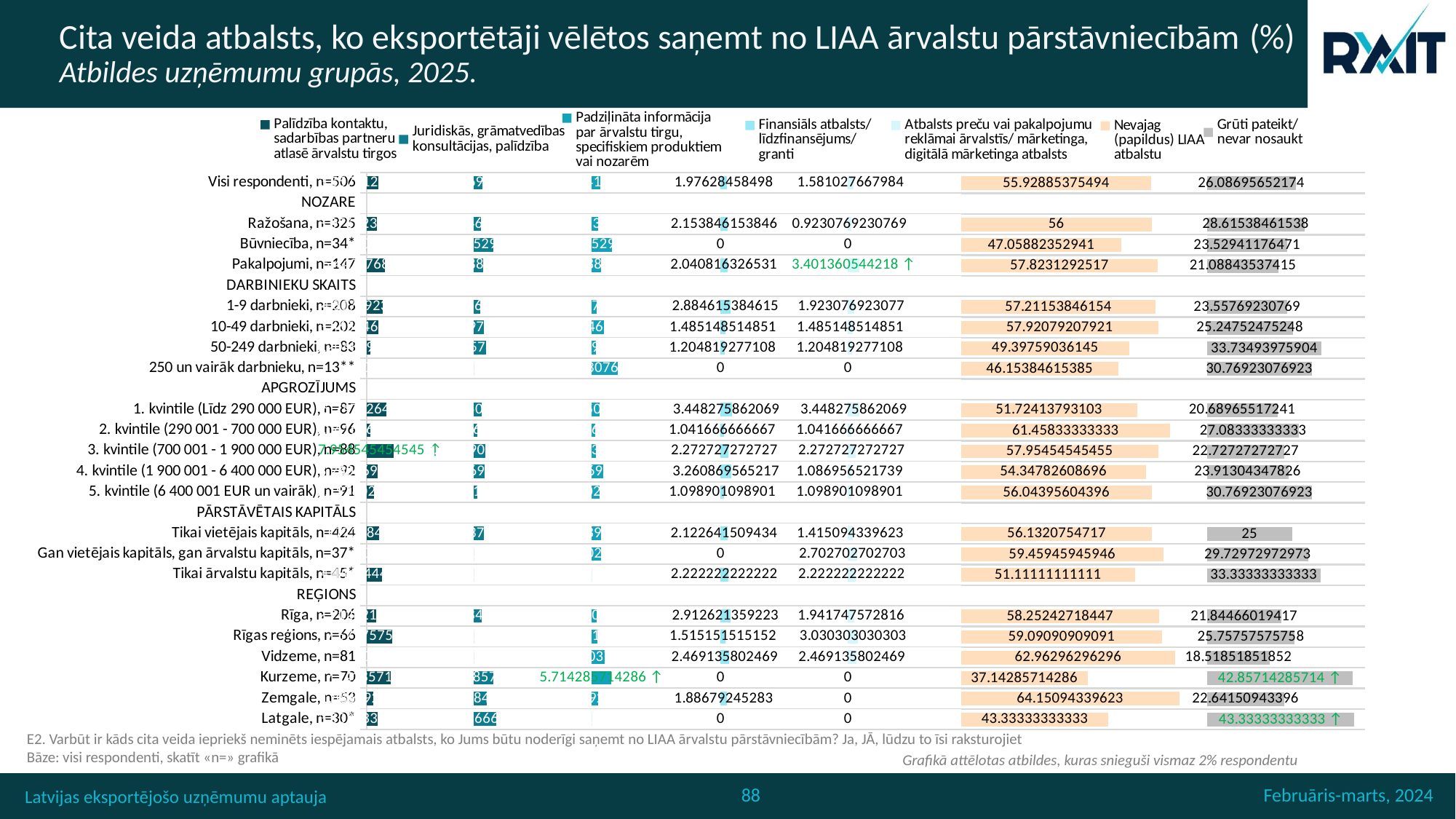
What is the value for 'Finansiāls atbalsts/ līdzfinansējums/ granti' for Būvniecība, n=34*? 0 What is the value for 'Grūti pateikt/ nevar nosaukt' for Tikai vietējais kapitāls, n=424? 25 What is the value for 'Nevajag (papildus) LIAA atbalstu' for Visi respondenti, n=506? 55.92885375494 Which group has the lowest value for 'Grūti pateikt/ nevar nosaukt'? Vidzeme, n=81 Which is larger for 'Grūti pateikt/ nevar nosaukt': 50-249 darbnieki, n=83 or 1-9 darbnieki, n=208? 50-249 darbnieki, n=83 Which group has the highest value for 'Nevajag (papildus) LIAA atbalstu'? Zemgale, n=53 How many regions are listed under REĢIONS? 6 What is the difference between the 'Nevajag (papildus) LIAA atbalstu' values for Ražošana, n=325 and Būvniecība, n=34*? 8.94117647059 What kind of chart is shown on the slide? Bar chart What is the value for 'Nevajag (papildus) LIAA atbalstu' for Ražošana, n=325? 56 Which group has the lowest value for 'Nevajag (papildus) LIAA atbalstu'? Kurzeme, n=70 How many series does the legend list? 7